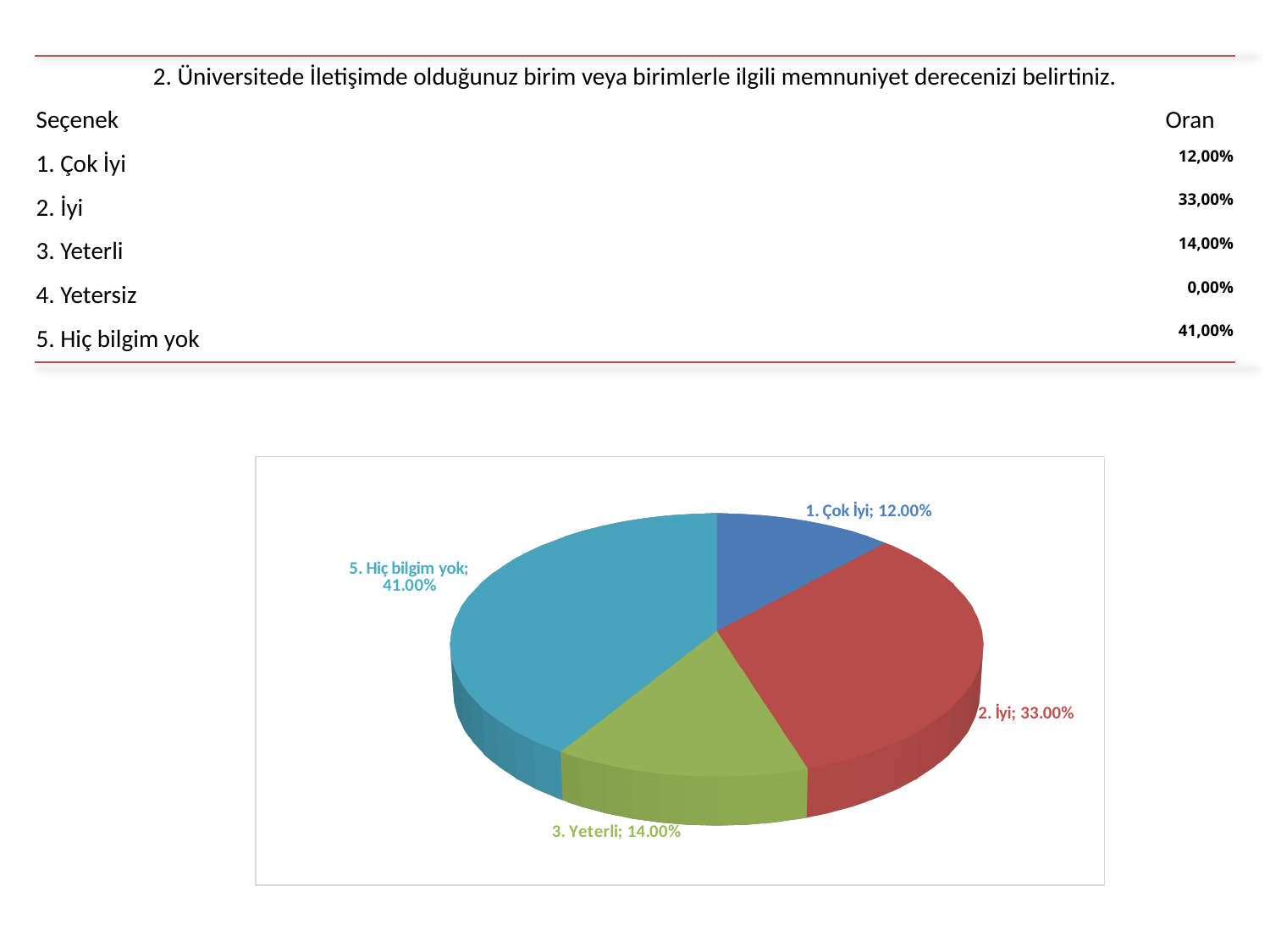
How many labelled slices does the pie chart show? 4 What is the value shown for "1. Çok İyi" in the pie chart? 12.00% What is the difference between the values for "5. Hiç bilgim yok" and "2. İyi" in the pie chart? 8.00% What colour is the "2. İyi" slice in the pie chart? Red What is the value shown for "5. Hiç bilgim yok" in the pie chart? 41.00% What is the value shown for "2. İyi" in the pie chart? 33.00% Which is larger in the pie chart, "3. Yeterli" or "1. Çok İyi"? 3. Yeterli What kind of chart is shown on the slide? Pie chart Which slice of the pie chart is the largest? 5. Hiç bilgim yok What is the value shown for "3. Yeterli" in the pie chart? 14.00% What is the combined share of "1. Çok İyi" and "2. İyi" in the pie chart? 45.00% Which labelled slice of the pie chart is the smallest? 1. Çok İyi